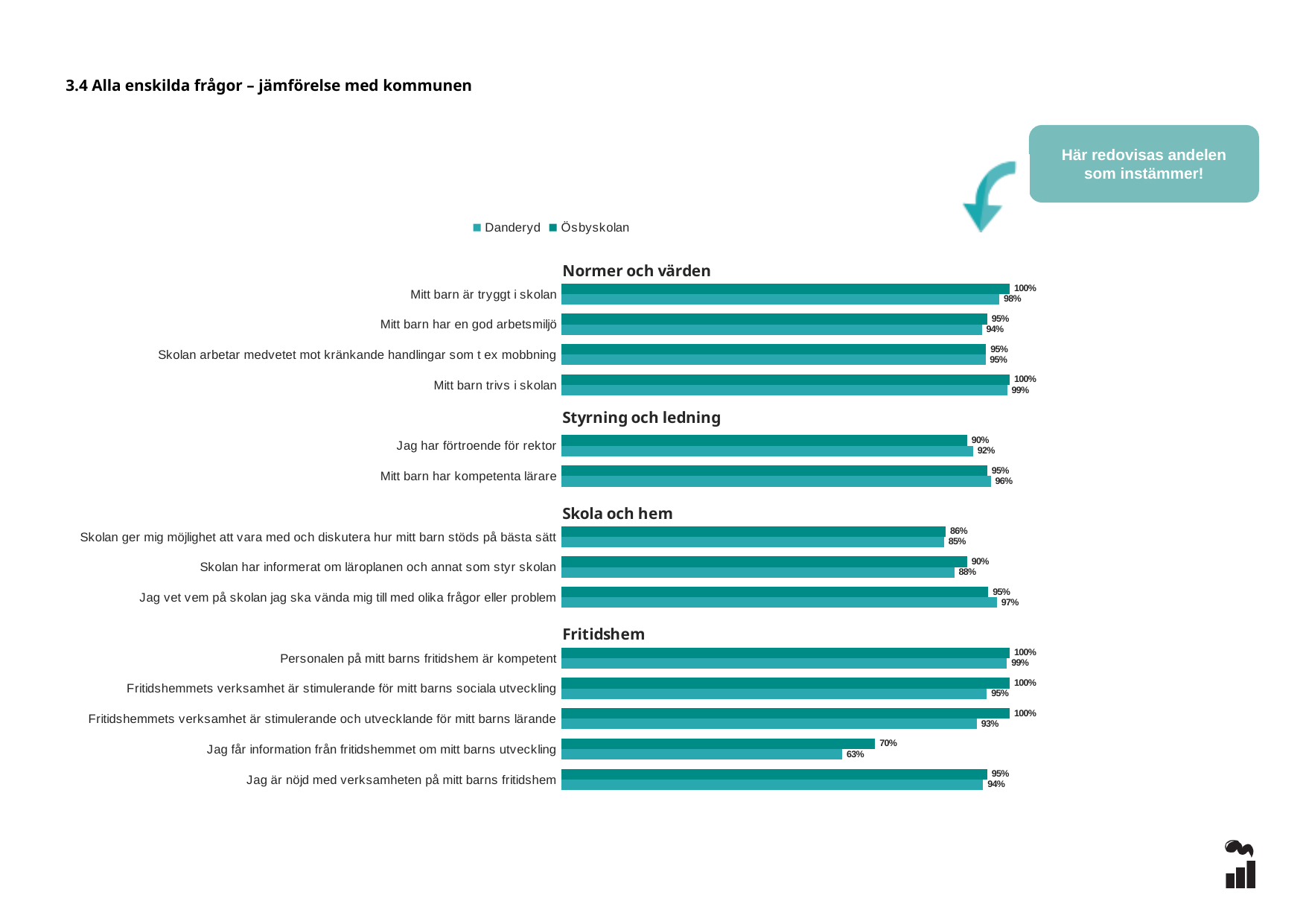
What kind of chart is shown on the slide? Bar chart What is the Ösbyskolan value for "Jag får information från fritidshemmet om mitt barns utveckling"? 70% How many section headings (e.g. Normer och värden) divide the chart? 4 What is the difference between the Ösbyskolan and Danderyd values for "Jag får information från fritidshemmet om mitt barns utveckling"? 7 percentage points What is the Ösbyskolan value for "Skolan ger mig möjlighet att vara med och diskutera hur mitt barn stöds på bästa sätt"? 86% What are the two series named in the chart legend? Danderyd and Ösbyskolan What is the Danderyd value for "Mitt barn trivs i skolan"? 99% What is the Danderyd value for "Jag får information från fritidshemmet om mitt barns utveckling"? 63% For "Jag har förtroende för rektor", which series has the higher value, Danderyd or Ösbyskolan? Danderyd How many series does the chart legend list? 2 How many individual questions (categories) are plotted in the chart? 14 Which question has the lowest values in the chart? Jag får information från fritidshemmet om mitt barns utveckling